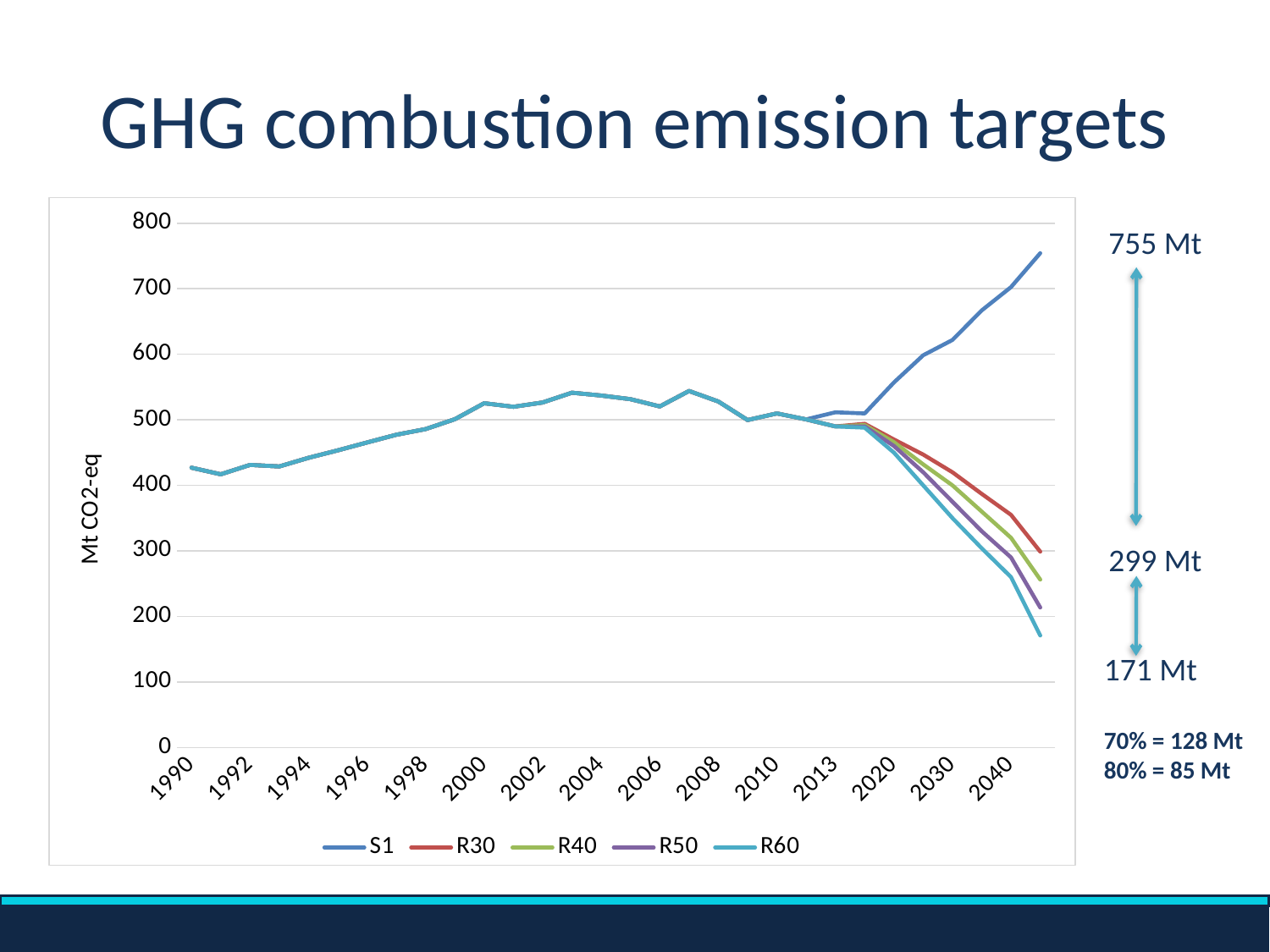
Is the value of S1 in 2030 greater or less than 600? greater Which series ends at the highest value at the right end of the chart? S1 What value is annotated at the end of the R60 line? 171 Mt What kind of chart is shown on the slide? line chart How many series does the legend list? 5 What value is annotated at the end of the S1 line? 755 Mt What is the difference between the annotated end values of S1 (755 Mt) and R30 (299 Mt)? 456 Mt What are the series names listed in the legend? S1, R30, R40, R50, R60 After 2020, does the S1 line rise or fall? rise Is the value of R60 in 2040 greater or less than 300? less Which series ends at the lowest value at the right end of the chart? R60 What is the label on the vertical axis? Mt CO2-eq